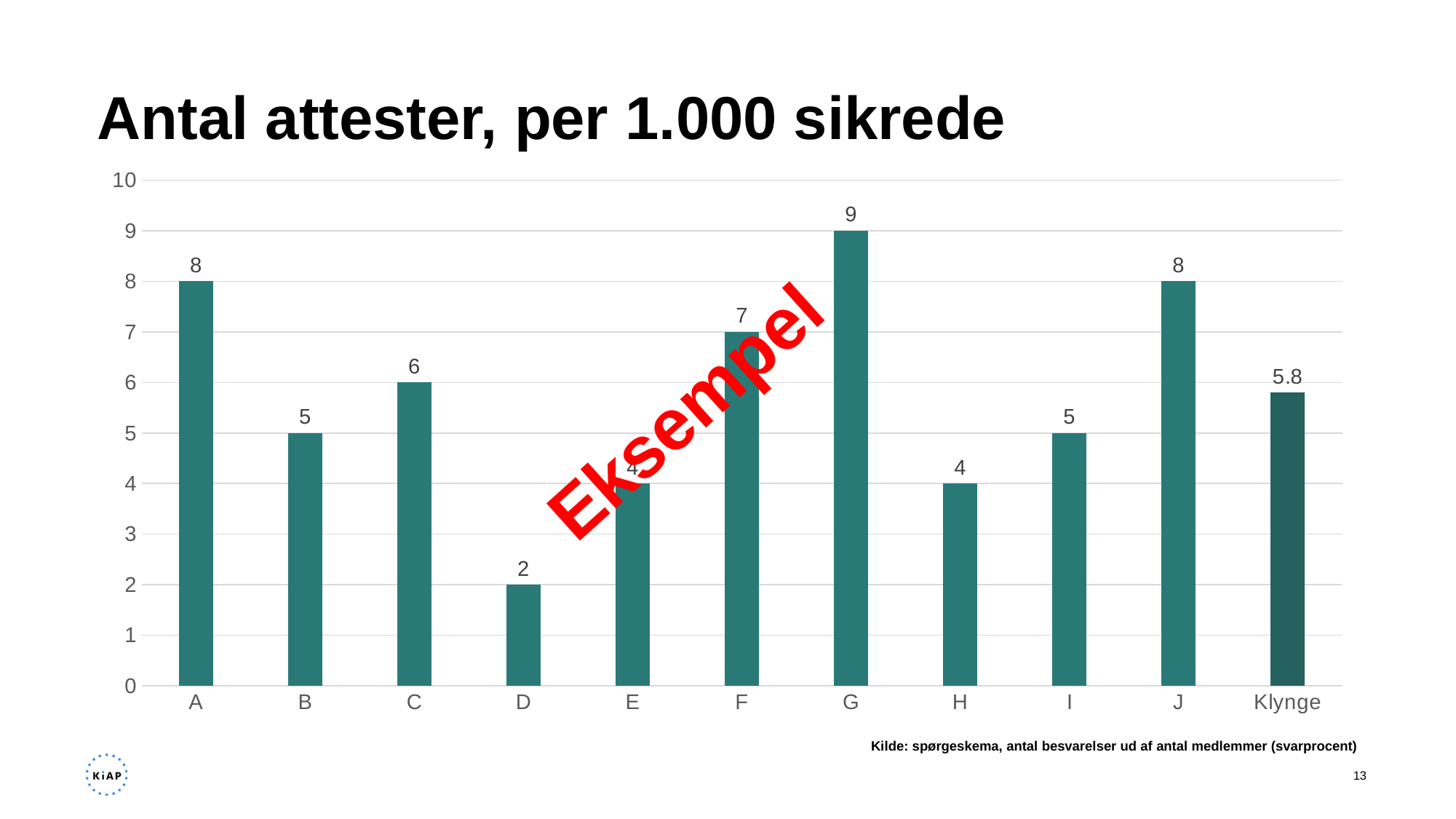
What is the value for G? 9 Which is larger, the value for C or the value for H? C What is the value for D? 2 What kind of chart is this? bar chart What is the difference between the values for J and Klynge? 2.2 How many categories are shown on the x axis? 11 What is the difference between the values for G and D? 7 Which category has the highest value? G What is the value for Klynge? 5.8 Is the value for F greater or less than 5? greater Which category has the lowest value? D What is the title of the chart? Antal attester, per 1.000 sikrede